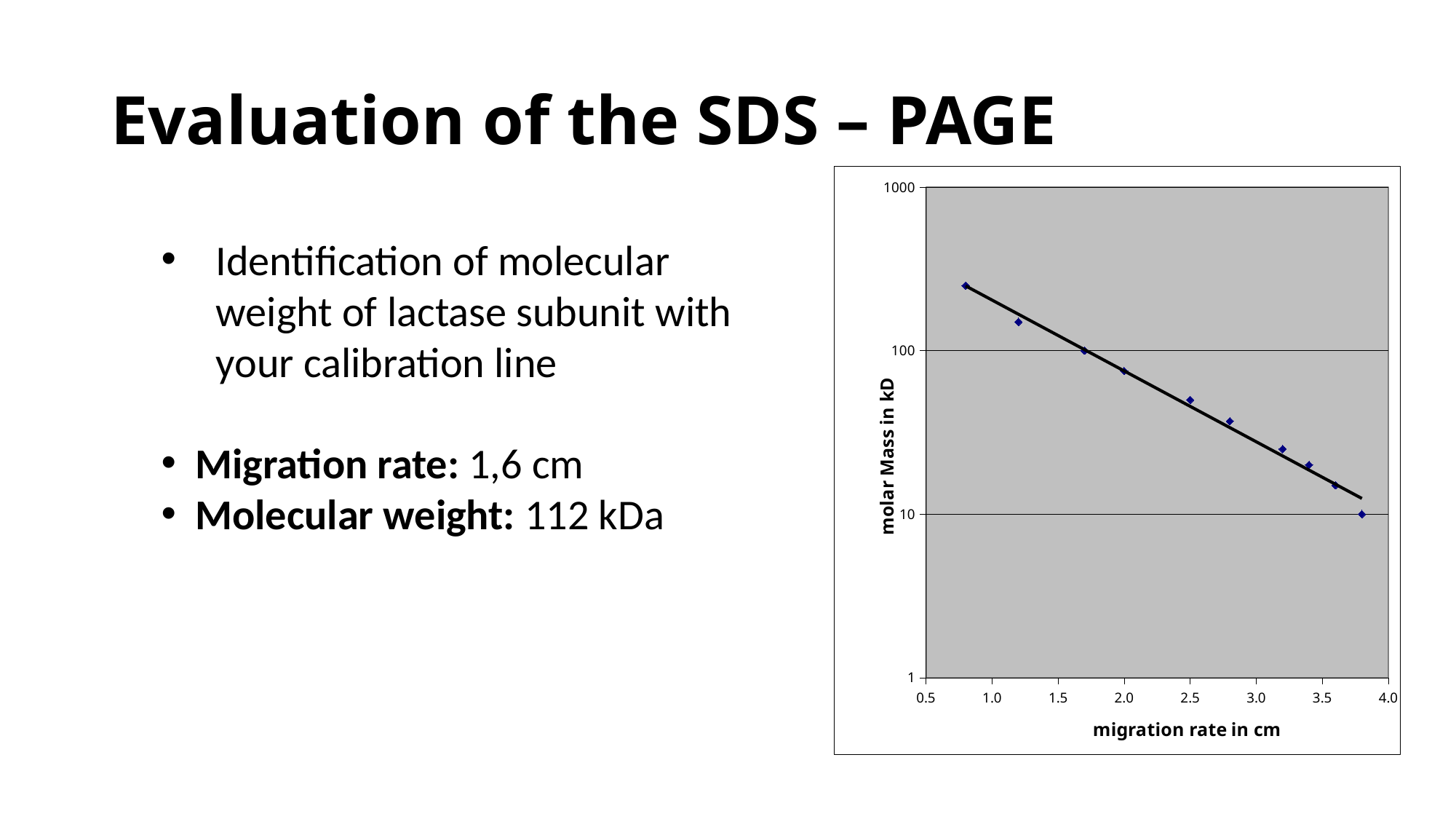
What is the title of the y axis of the chart? molar Mass in kD At which migration rate does the point with the highest molar mass lie? 0.8 cm What kind of chart is shown on the slide? scatter chart Do the plotted values rise or fall as the migration rate increases? fall Which point has the highest molar mass: the one at 0.8 cm or the one at 3.8 cm? the one at 0.8 cm Is the molar mass of the point at a migration rate of 2.5 cm greater or less than 100? less Is the molar mass of the point at a migration rate of 0.8 cm greater or less than 100? greater How many data points are plotted on the chart? 10 Is the molar mass of the point at a migration rate of 3.4 cm greater or less than 10? greater What is the title of the x axis of the chart? migration rate in cm At which migration rate does the point with the lowest molar mass lie? 3.8 cm